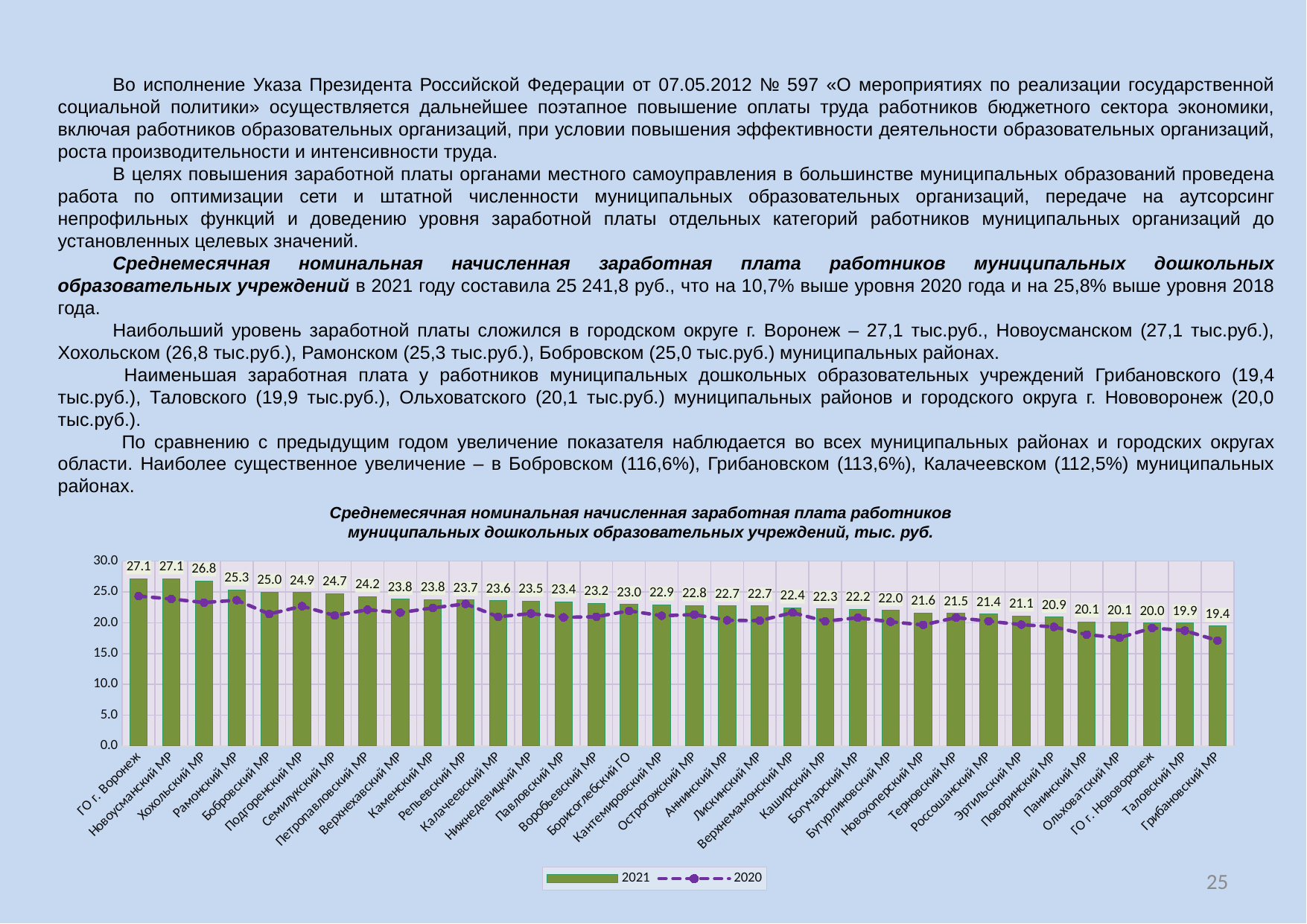
How many categories are shown on the x axis? 34 Do the 2021 bar values rise or fall from left to right along the x axis? fall Which has the larger 2021 value, Семилукский МР or Каширский МР? Семилукский МР Is the 2020 value for Грибановский МР greater or less than 20.0? less What is the 2021 value for Бобровский МР? 25.0 What is the 2021 value for Грибановский МР? 19.4 How many series does the legend list? 2 What is the 2021 value for Хохольский МР? 26.8 Which category has the lowest 2021 value? Грибановский МР What is the difference between the 2021 values for Рамонский МР and Таловский МР? 5.4 What is the 2021 value for Лискинский МР? 22.7 Is the 2020 value for ГО г. Воронеж greater or less than 20.0? greater